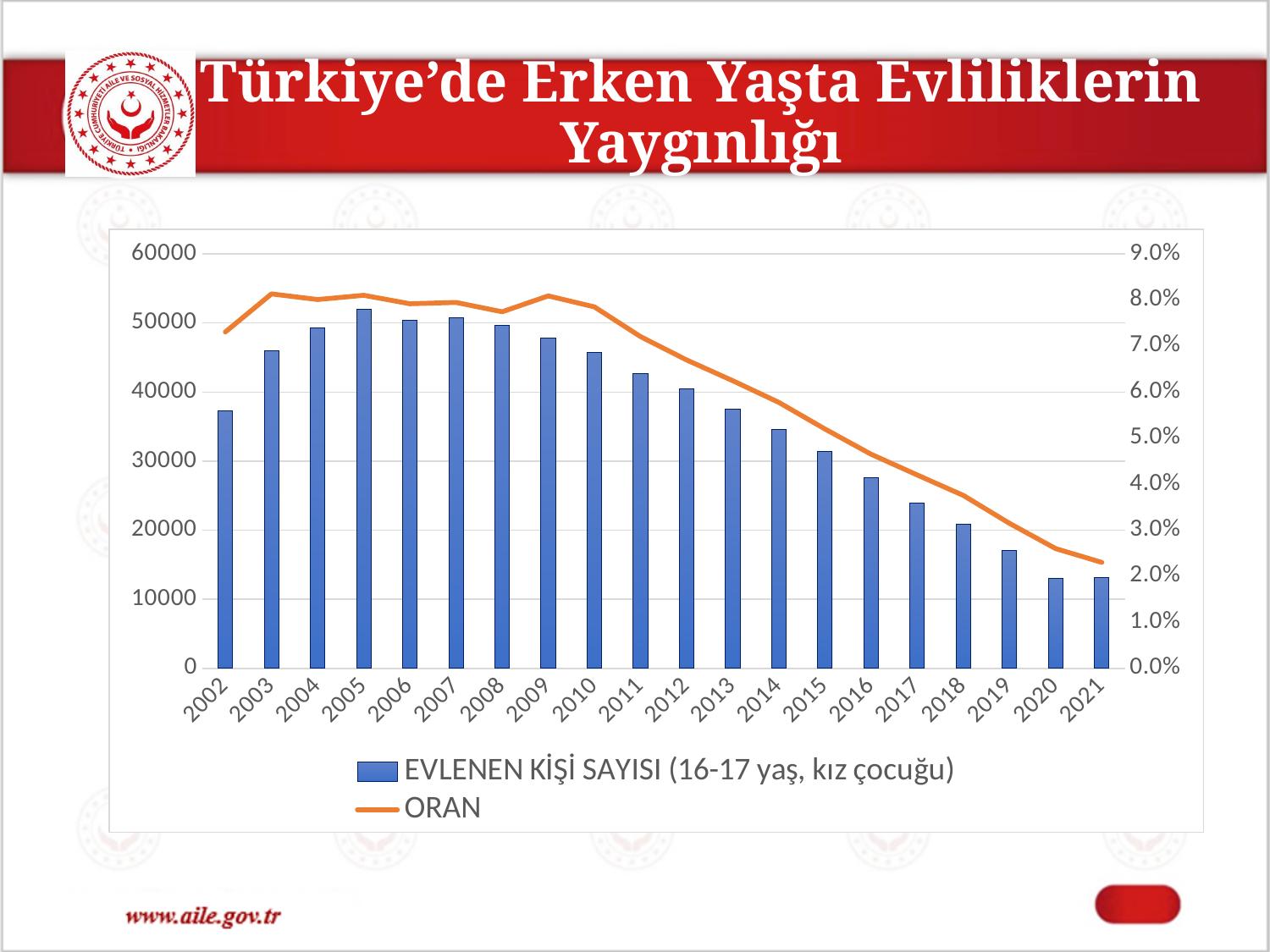
Which year has the tallest bar for EVLENEN KİŞİ SAYISI (16-17 yaş, kız çocuğu)? 2005 What kind of chart is shown on the slide? A combination bar and line chart Is the bar value for 2019 greater or less than 20000? less Which year has the larger bar value, 2003 or 2015? 2003 Is the bar value for 2002 greater or less than 40000? less How many series does the chart's legend list? 2 Is the ORAN value for 2021 greater or less than 3.0%? less What colour is the ORAN line in the chart? Orange How many years are shown along the x axis of the chart? 20 Do the bar values rise or fall from 2010 to 2021? fall